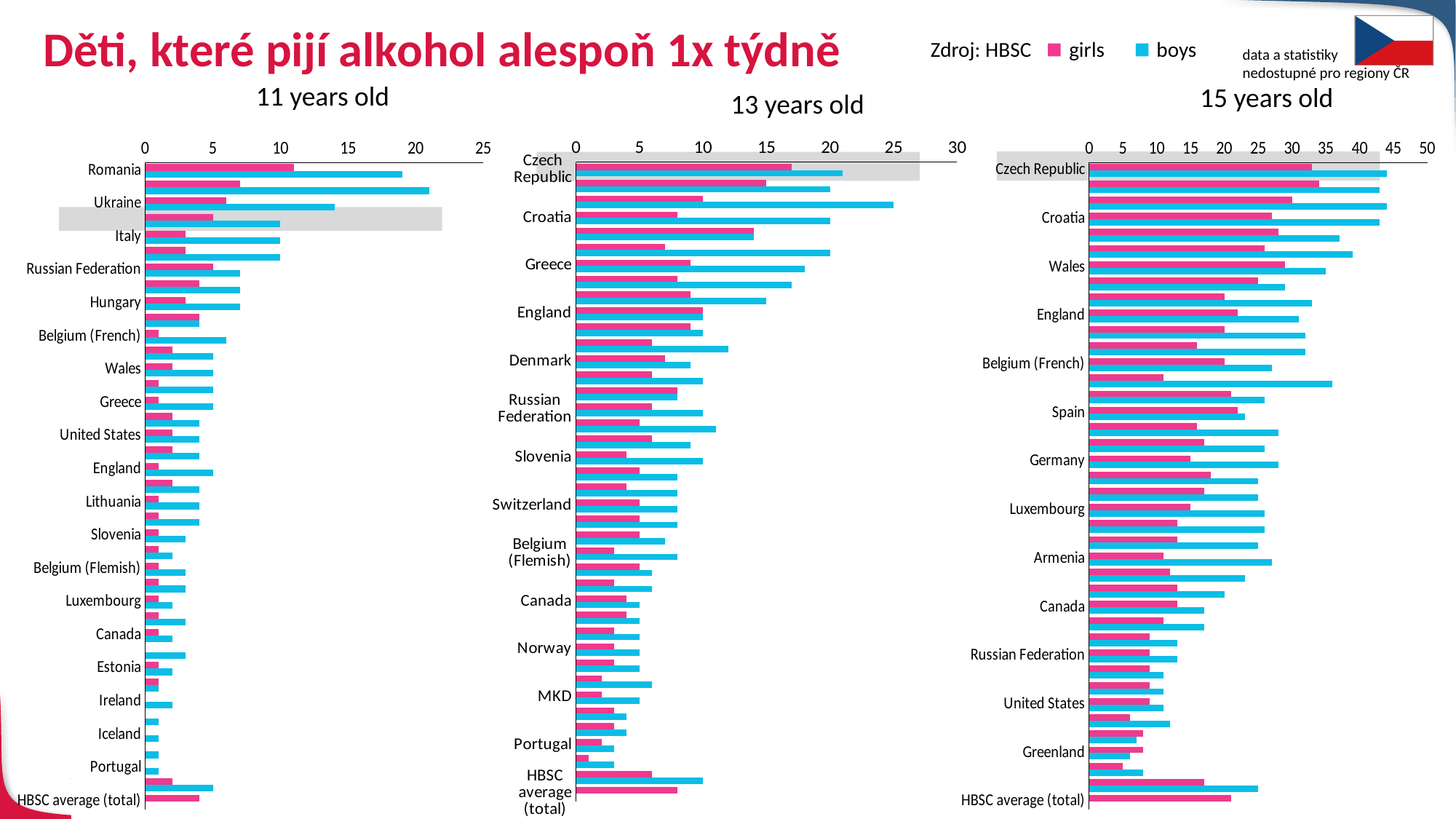
In the '15 years old' chart, is the boys value for Czech Republic greater or less than 40? greater In the '15 years old' chart, is the girls value for Greenland greater or less than 10? less How many series does the legend list? 2 In the '11 years old' chart, is the boys value for Romania greater or less than 15? greater In the '15 years old' chart, which is larger for Czech Republic, the girls value or the boys value? boys In the '15 years old' chart, do the boys values generally increase or decrease going from the top category to the bottom category? decrease In the '11 years old' chart, which is larger for Romania, the girls value or the boys value? boys What kind of chart is the '11 years old' chart? bar chart What are the two series named in the legend? girls and boys How many charts are shown on the slide? 3